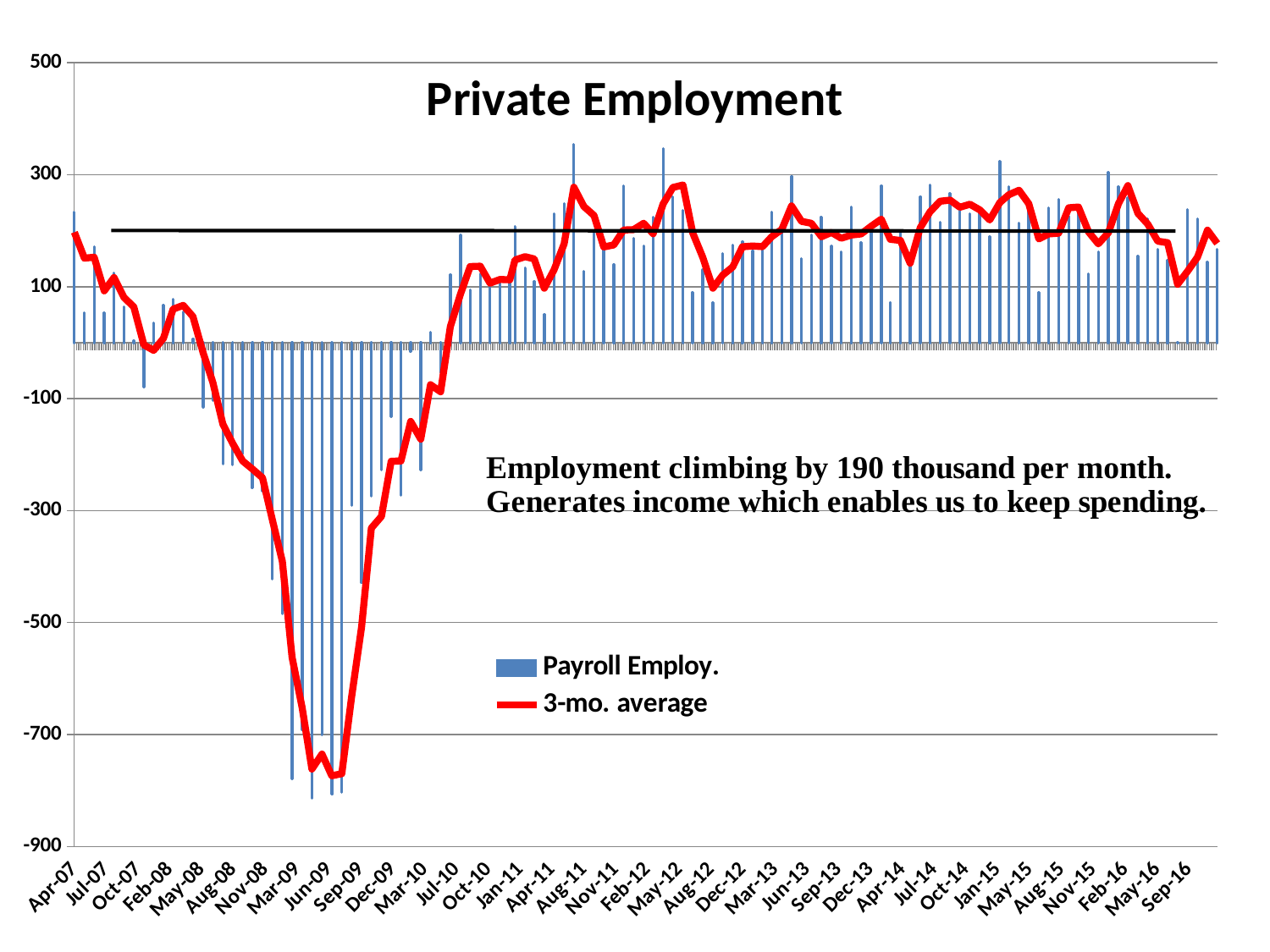
Does the 3-mo. average rise or fall between Jun-09 and Jul-10? rise Is the 3-mo. average in Aug-11 greater or less than 100? greater What is the title of the chart? Private Employment Is the 3-mo. average in Apr-07 greater or less than 100? greater What kind of chart is shown on the slide? A bar chart with a line overlay In which year does the 3-mo. average reach its lowest point? 2009 According to the text on the slide, by how much is employment climbing per month? 190 thousand Is the 3-mo. average around Jun-09 greater or less than -700? less How many series does the legend list? 2 Is the 3-mo. average higher in Aug-11 or in Aug-12? Aug-11 Does the 3-mo. average rise or fall between Aug-08 and Mar-09? fall